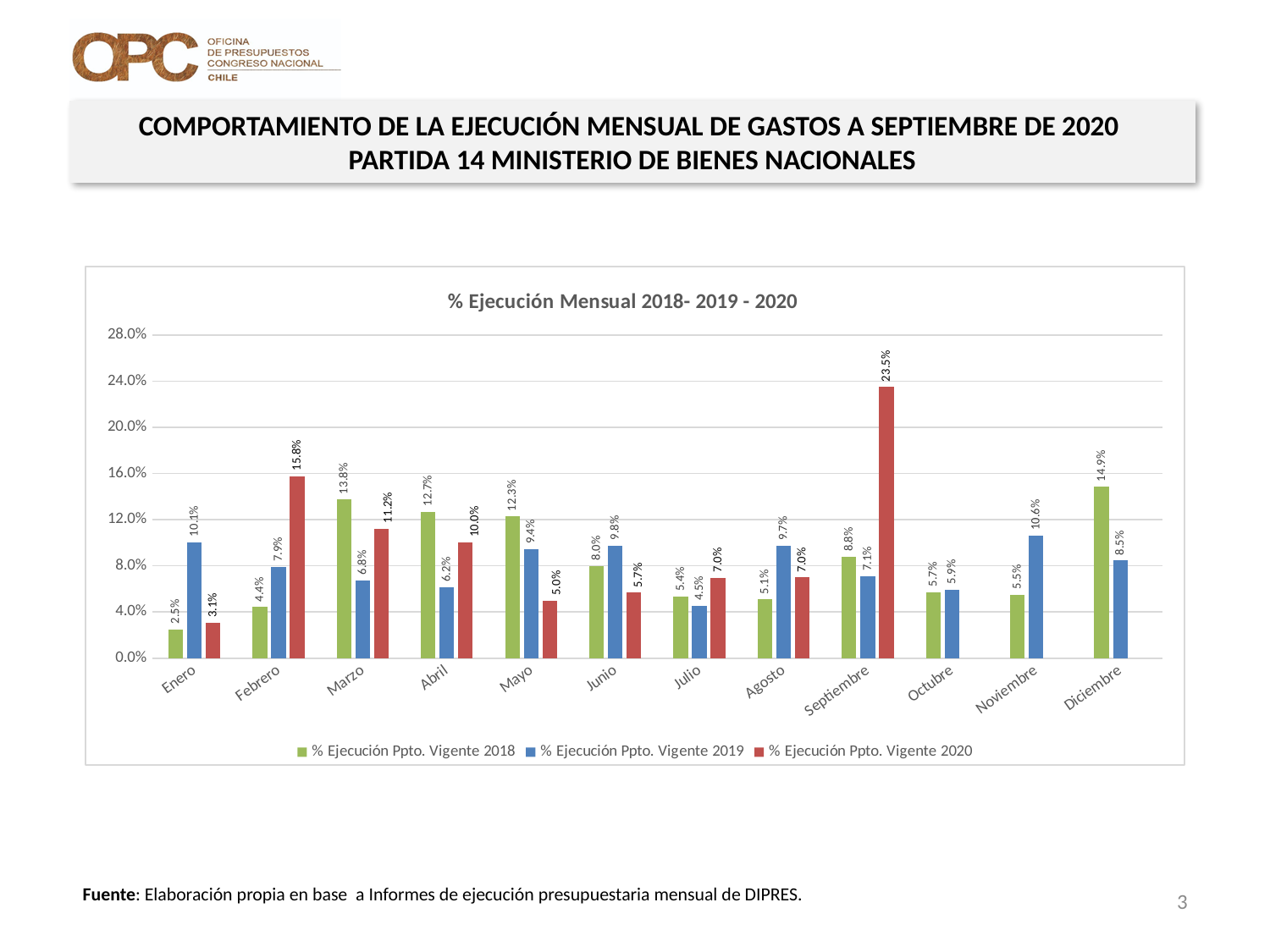
What is the difference between the 2020 and 2018 values in Febrero? 11.4% What kind of chart is shown? Bar chart How many series does the legend list? 3 Is the value for % Ejecución Ppto. Vigente 2020 in Septiembre greater or less than 20.0%? greater Which is larger in Mayo: the 2018 value or the 2019 value? 2018 (12.3%) What is the value for % Ejecución Ppto. Vigente 2018 in Marzo? 13.8% In which month is the % Ejecución Ppto. Vigente 2020 value highest? Septiembre How many months are shown on the x axis? 12 What is the value for % Ejecución Ppto. Vigente 2020 in Septiembre? 23.5% What is the title of the chart? % Ejecución Mensual 2018- 2019 - 2020 What is the value for % Ejecución Ppto. Vigente 2019 in Noviembre? 10.6% In which month is the % Ejecución Ppto. Vigente 2018 value lowest? Enero